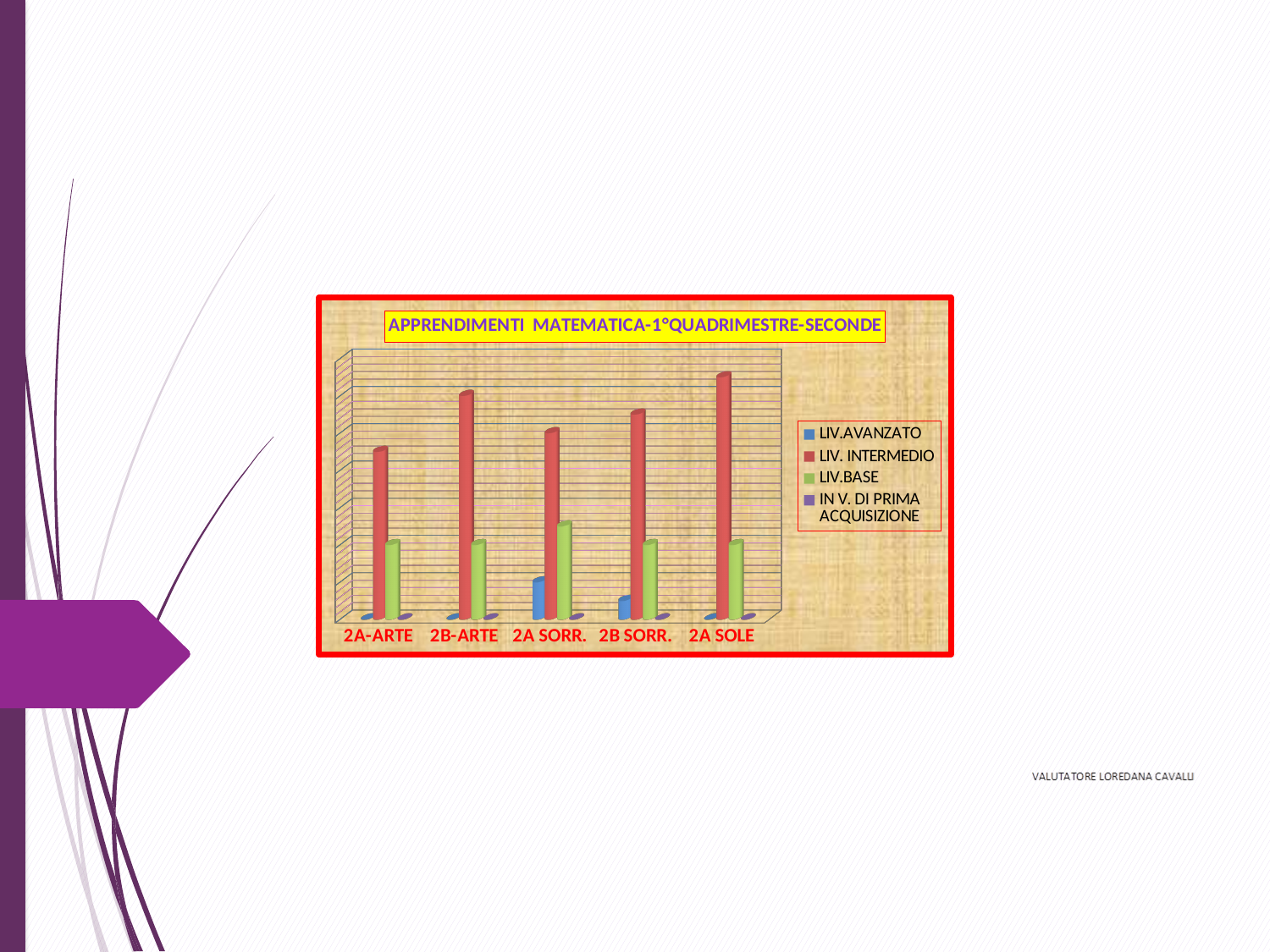
Which class has the highest LIV. INTERMEDIO bar? 2A SOLE Which class has the lowest LIV. INTERMEDIO bar? 2A-ARTE Is the LIV. INTERMEDIO value larger for 2B-ARTE or for 2B SORR.? 2B-ARTE How many series does the chart's legend list? 4 Which class has the highest LIV.BASE bar? 2A SORR. What is the title of the chart? APPRENDIMENTI MATEMATICA-1°QUADRIMESTRE-SECONDE How many classes (categories) are shown on the x axis of the chart? 5 Is the LIV.AVANZATO value larger for 2A SORR. or for 2B SORR.? 2A SORR. Which colour represents LIV. INTERMEDIO in the chart? Red Which class has the highest LIV.AVANZATO bar? 2A SORR. What kind of chart is shown on the slide? Bar chart